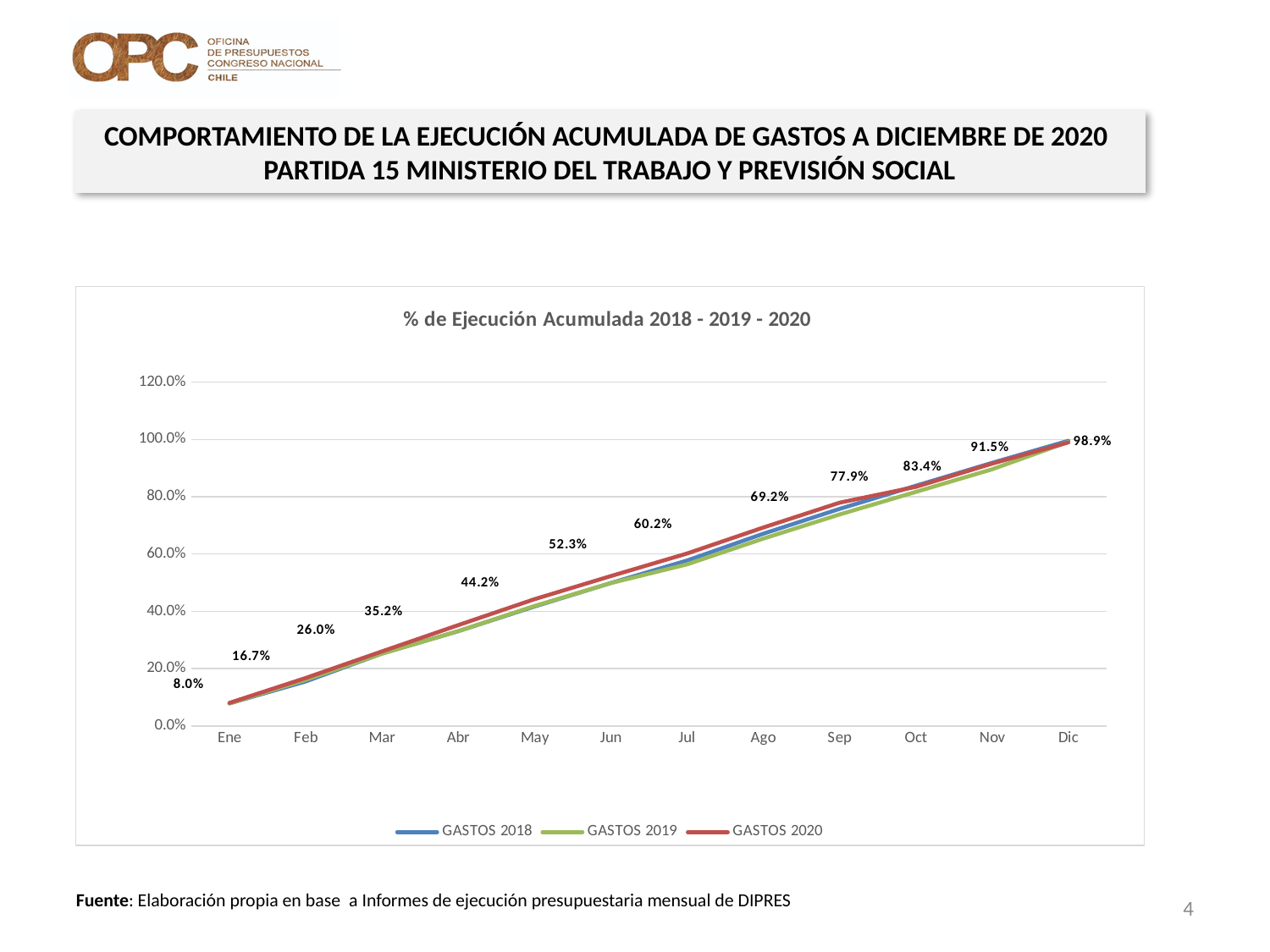
Which month has the highest labelled value on the chart? Dic According to the data labels on the chart, what value is shown for Sep? 77.9% According to the data labels on the chart, what value is shown for Dic? 98.9% Which month has the lowest labelled value on the chart? Ene What is the title of the chart? % de Ejecución Acumulada 2018 - 2019 - 2020 How many series does the chart legend list? 3 According to the data labels on the chart, what value is shown for Ene? 8.0% How many months are plotted along the x axis of the chart? 12 What kind of chart is shown on the slide? Line chart According to the data labels on the chart, what value is shown for Jun? 52.3% What is the difference between the labelled values for Dic and Nov? 7.4 percentage points Do the plotted values rise or fall from Ene to Dic? Rise